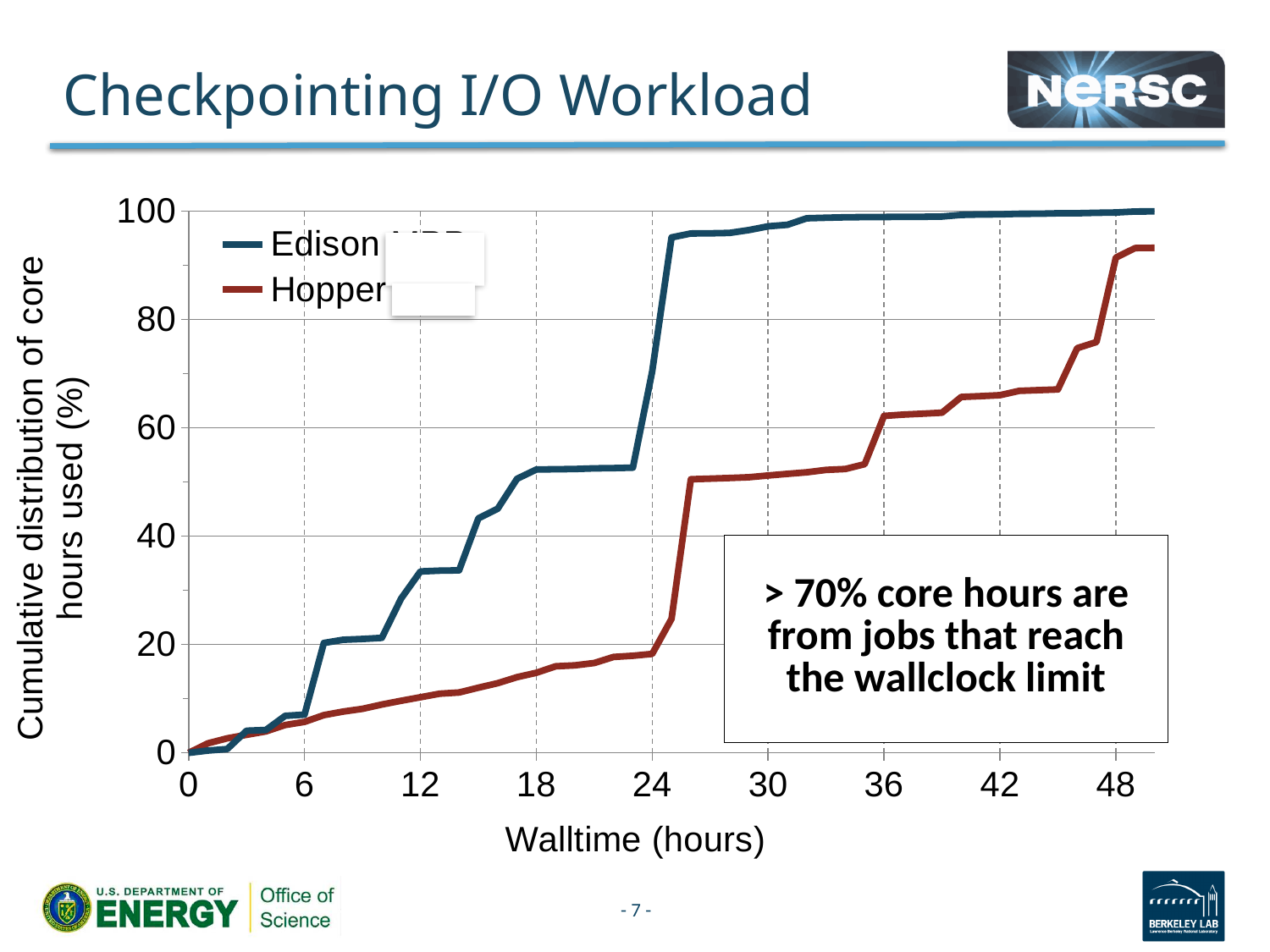
Which series is drawn in red? Hopper At a walltime of 30 hours, which series has the higher value, Edison or Hopper? Edison Is the value for Hopper at a walltime of 12 hours greater or less than 20? less Do the values for Hopper rise or fall as walltime increases? rise Is the value for Hopper at a walltime of 30 hours greater or less than 60? less Is the value for Edison at a walltime of 12 hours greater or less than 20? greater What kind of chart is shown on the slide? line chart At a walltime of 18 hours, which series has the higher value, Edison or Hopper? Edison What is the title of the x axis? Walltime (hours) How many series does the legend list? 2